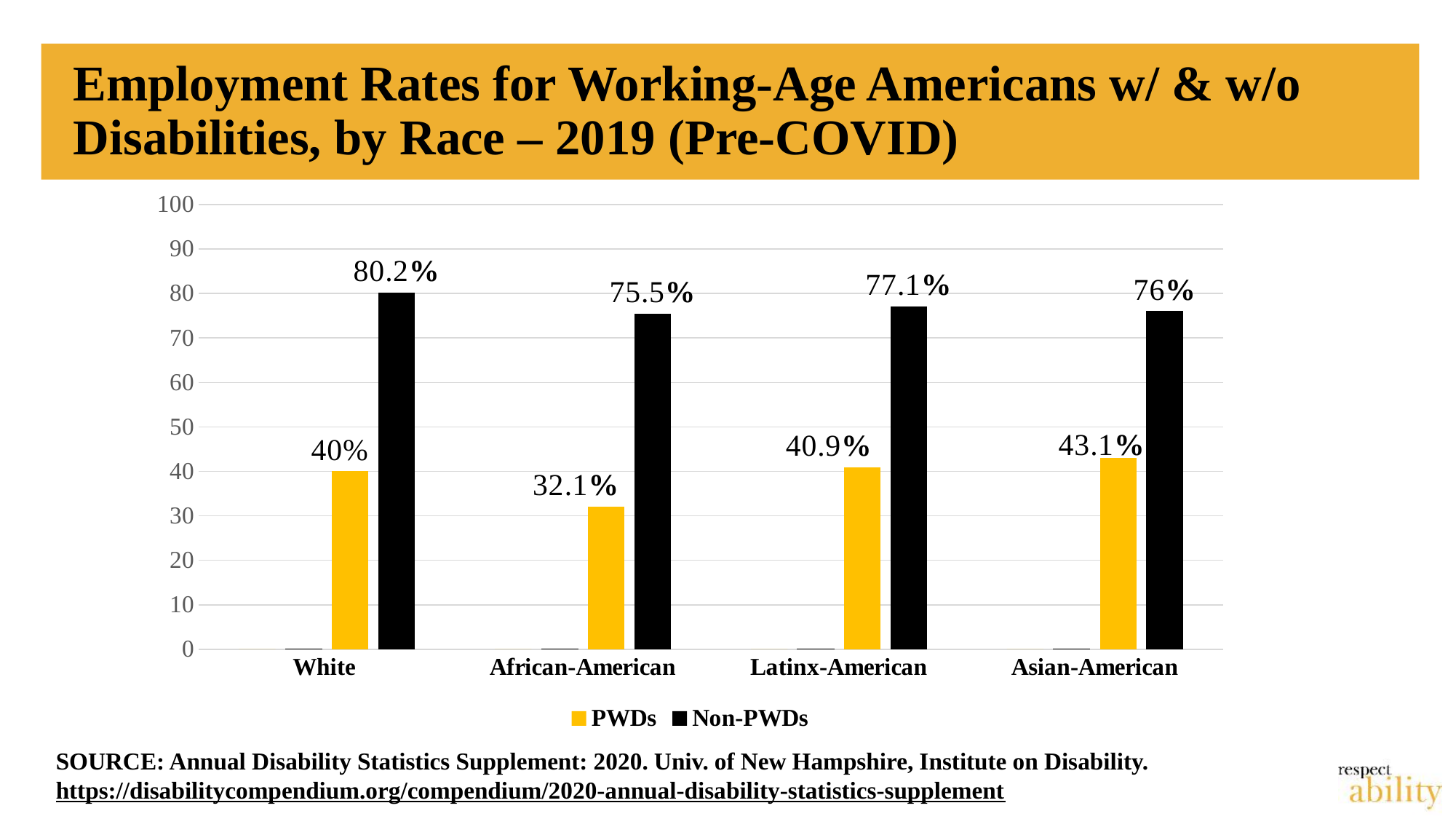
What is the employment rate for PWDs in the White category? 40% Which race category has the lowest PWDs employment rate? African-American What is the difference between the Non-PWDs and PWDs employment rates for the White category? 40.2% What is the employment rate for Non-PWDs in the Asian-American category? 76% Which race category has the highest Non-PWDs employment rate? White Which is larger, the PWDs employment rate for Asian-American or for Latinx-American? Asian-American What is the employment rate for PWDs in the Latinx-American category? 40.9% How many race categories are shown on the x axis? 4 What is the employment rate for Non-PWDs in the African-American category? 75.5% What kind of chart is shown on the slide? Bar chart Which colour represents the PWDs series in the legend? Yellow How many series does the legend list? 2